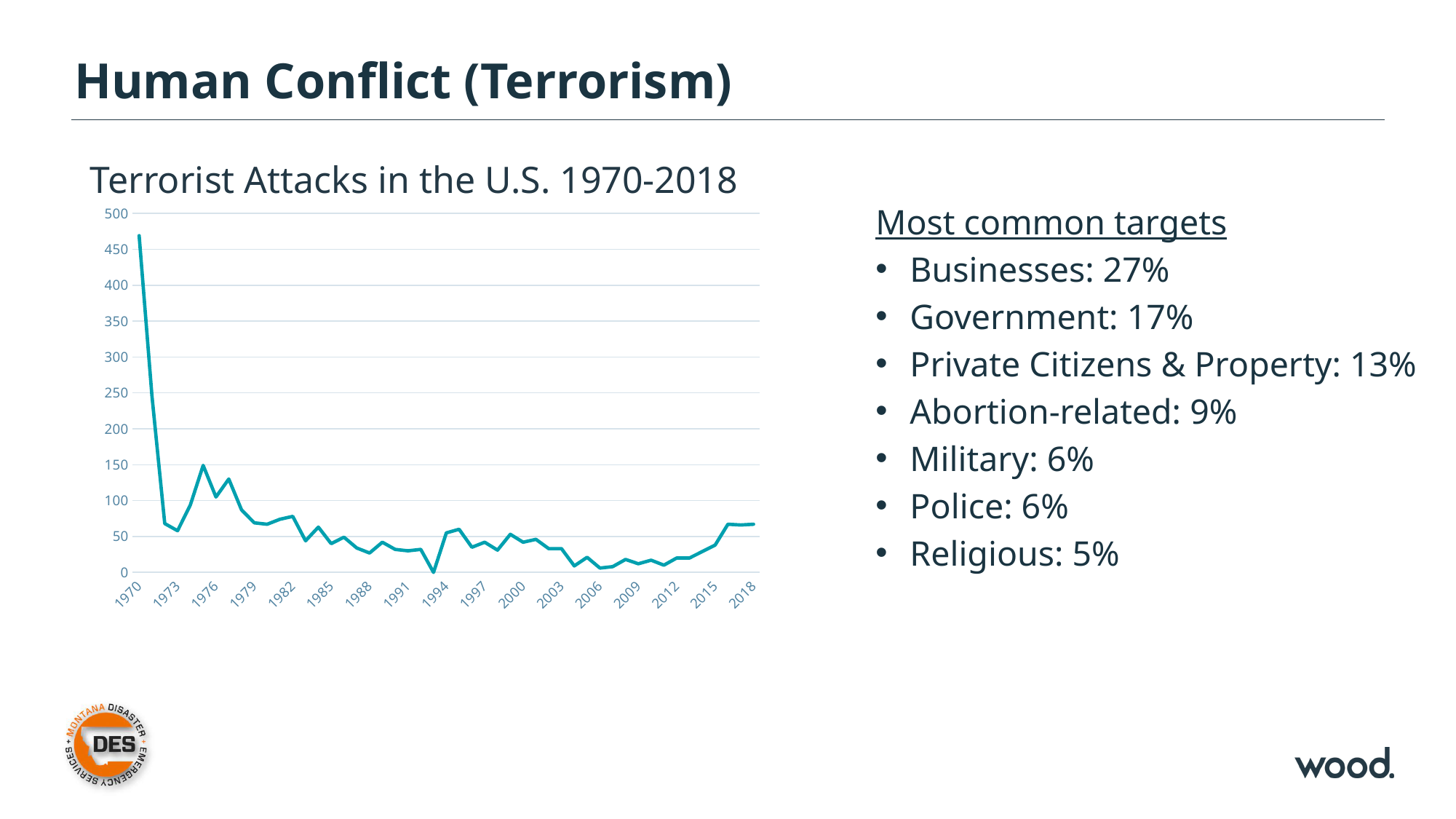
Do the values generally rise or fall from 1970 to 2006? fall Is the value for 2006 greater or less than 50? less Which year has the larger value, 1970 or 1976? 1970 What is the title of the chart? Terrorist Attacks in the U.S. 1970-2018 Is the value for 1970 greater or less than 400? greater What kind of chart is shown on the slide? line chart Which year has the highest number of terrorist attacks in the chart? 1970 Is the value for 2018 greater or less than 50? greater How many year labels are shown on the x axis? 17